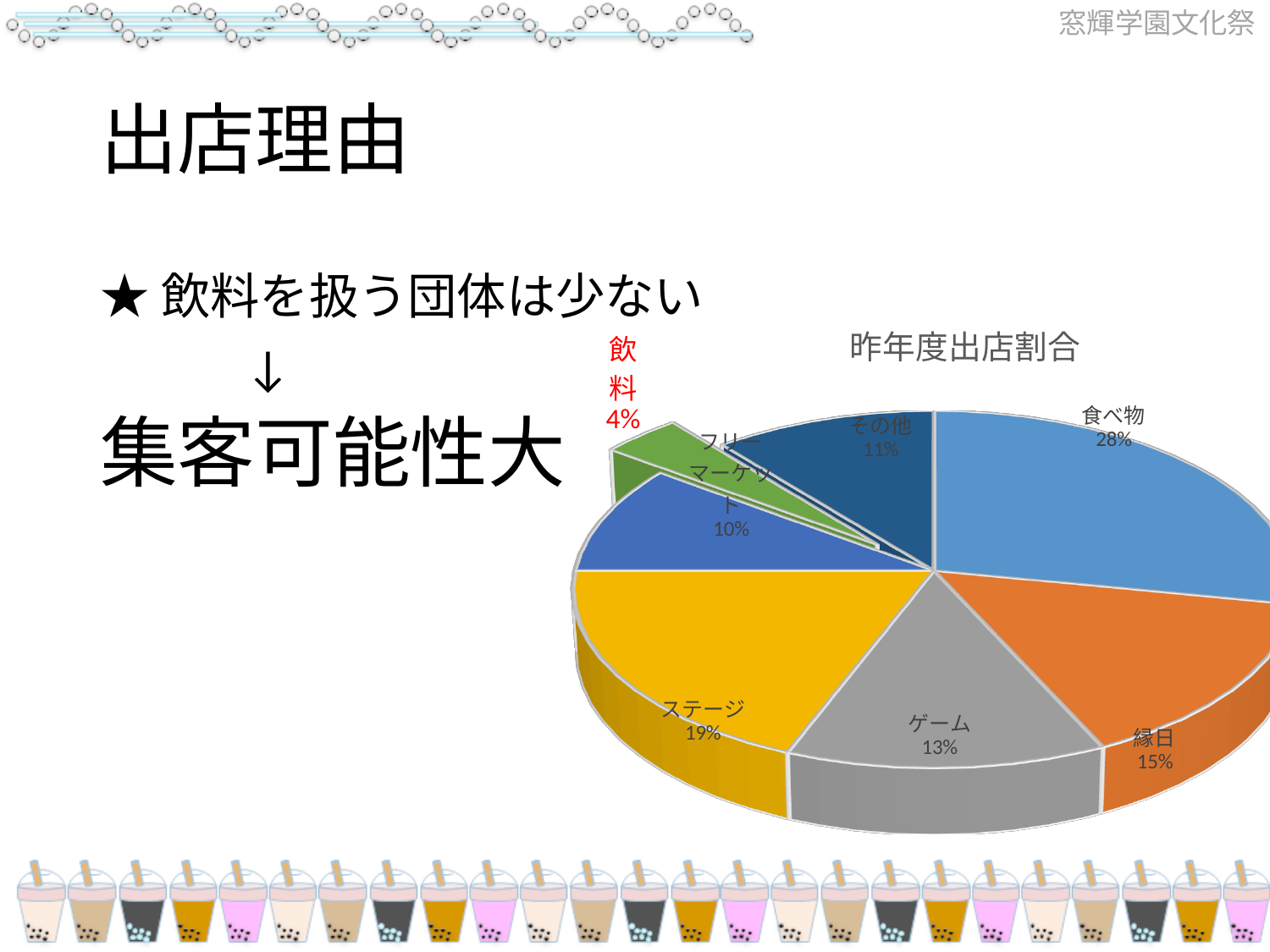
Which category has the smallest share of the pie? 飲料 What type of chart is shown on the slide? pie chart What percentage is shown for フリーマーケット? 10% What is the difference in percentage points between ステージ and フリーマーケット? 9 Which category has the largest share of the pie? 食べ物 Which is larger, ゲーム or その他? ゲーム What percentage is shown for 飲料? 4% What is the difference in percentage points between 食べ物 and 縁日? 13 What share of the pie does 食べ物 have? 28% How many slices does the pie chart have? 7 What percentage is shown for ステージ? 19% What is the title of the chart? 昨年度出店割合